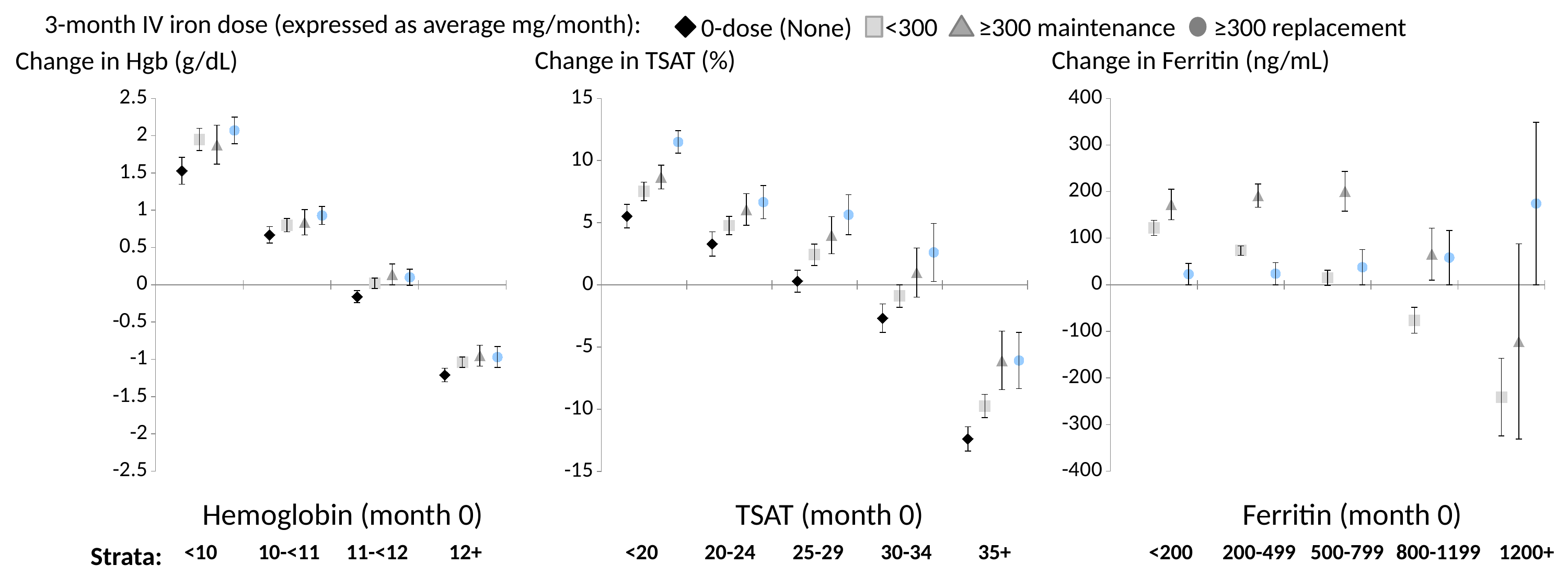
In the Change in Hgb chart, is the value for the 0-dose (None) series in the 12+ stratum greater or less than -1? less In the Change in Hgb chart, is the value for the 0-dose (None) series in the <10 stratum greater or less than 1? greater In the Change in TSAT chart, how many TSAT strata are shown on the x axis? 5 How many series does the legend at the top of the slide list? 4 In the Change in TSAT chart, is the value for the ≥300 replacement series in the <20 stratum greater or less than 10? greater In the Change in Hgb chart, how many hemoglobin strata are shown on the x axis? 4 In the Change in TSAT chart, in the 35+ stratum, which is larger: the value for the 0-dose (None) series or the <300 series? <300 In the Change in Hgb chart, do the 0-dose (None) values rise or fall as the hemoglobin strata increase from <10 to 12+? fall What is the y-axis title of the middle chart? Change in TSAT (%) In the Change in Hgb chart, which hemoglobin stratum has the highest value for the 0-dose (None) series? <10